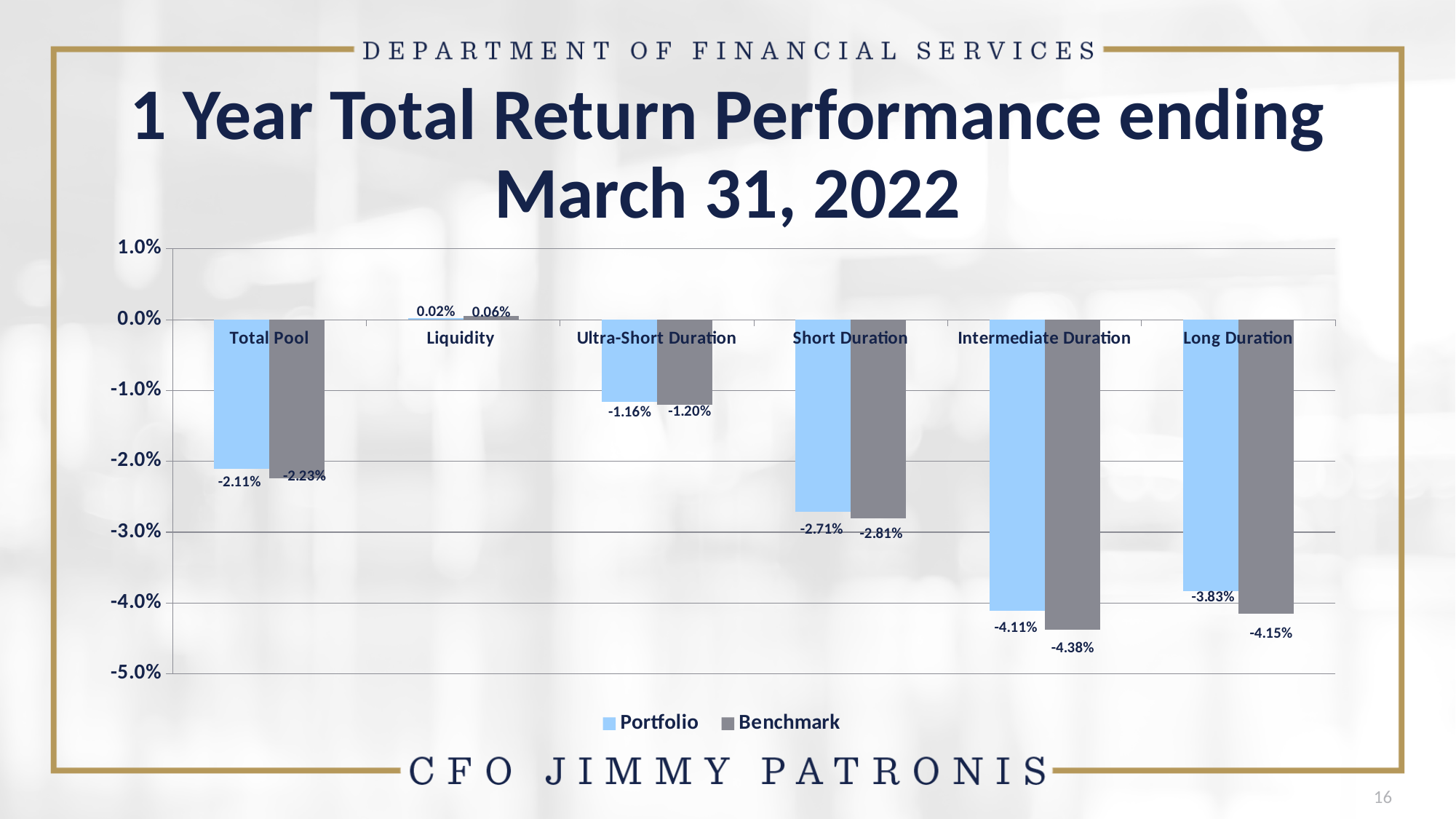
What is the difference between the Portfolio and Benchmark values for Short Duration? 0.10% What kind of chart is shown on the slide? Bar chart What colour are the Benchmark bars? Grey What is the Benchmark value for Long Duration? -4.15% How many series does the legend list? 2 What is the Portfolio value for Total Pool? -2.11% Which category has the highest Portfolio value? Liquidity Which is larger, the Portfolio value for Long Duration or the Portfolio value for Intermediate Duration? Long Duration How many categories are shown on the x axis? 6 What is the Benchmark value for Intermediate Duration? -4.38% Which category has the lowest Benchmark value? Intermediate Duration What is the Portfolio value for Liquidity? 0.02%